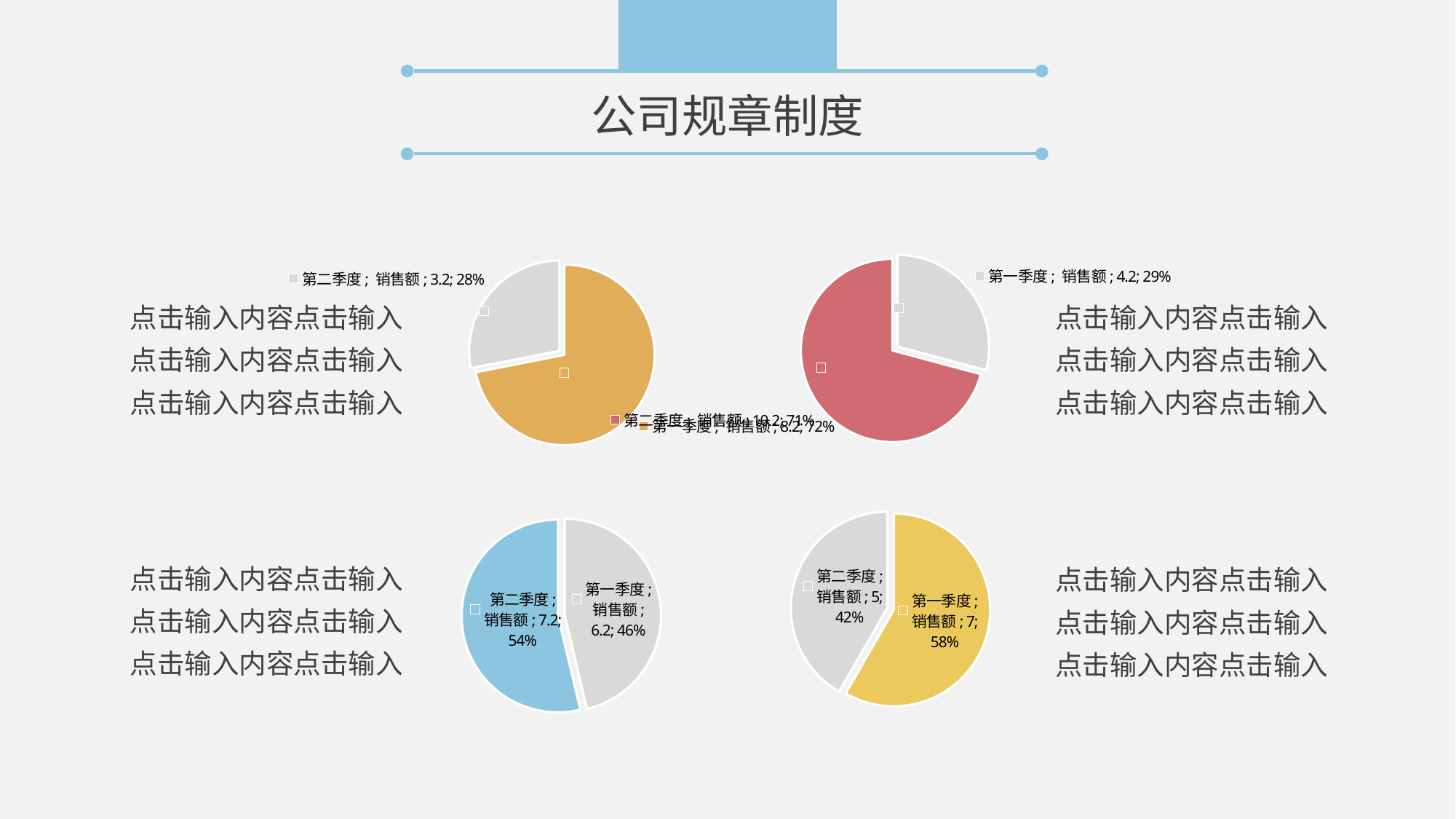
What kind of charts are shown on the slide? Pie charts How many pie charts are on the slide? 4 In the bottom-left pie chart, what share of the pie does 第一季度 take? 46% In the bottom-right pie chart, which quarter has the larger slice? 第一季度 In the bottom-right pie chart, what is the sales value (销售额) for 第一季度? 7 In the bottom-left pie chart, what is the difference between the sales values of 第二季度 and 第一季度? 1 In the bottom-left pie chart, what is the sales value (销售额) for 第二季度? 7.2 In the top-left pie chart, what share of the pie does 第二季度 take? 28% In the top-right pie chart, what is the sales value (销售额) for 第一季度? 4.2 In the bottom-right pie chart, what share of the pie does 第二季度 take? 42% In the bottom-right pie chart, what is the difference between the sales values of 第一季度 and 第二季度? 2 In the bottom-left pie chart, which quarter has the smaller slice? 第一季度